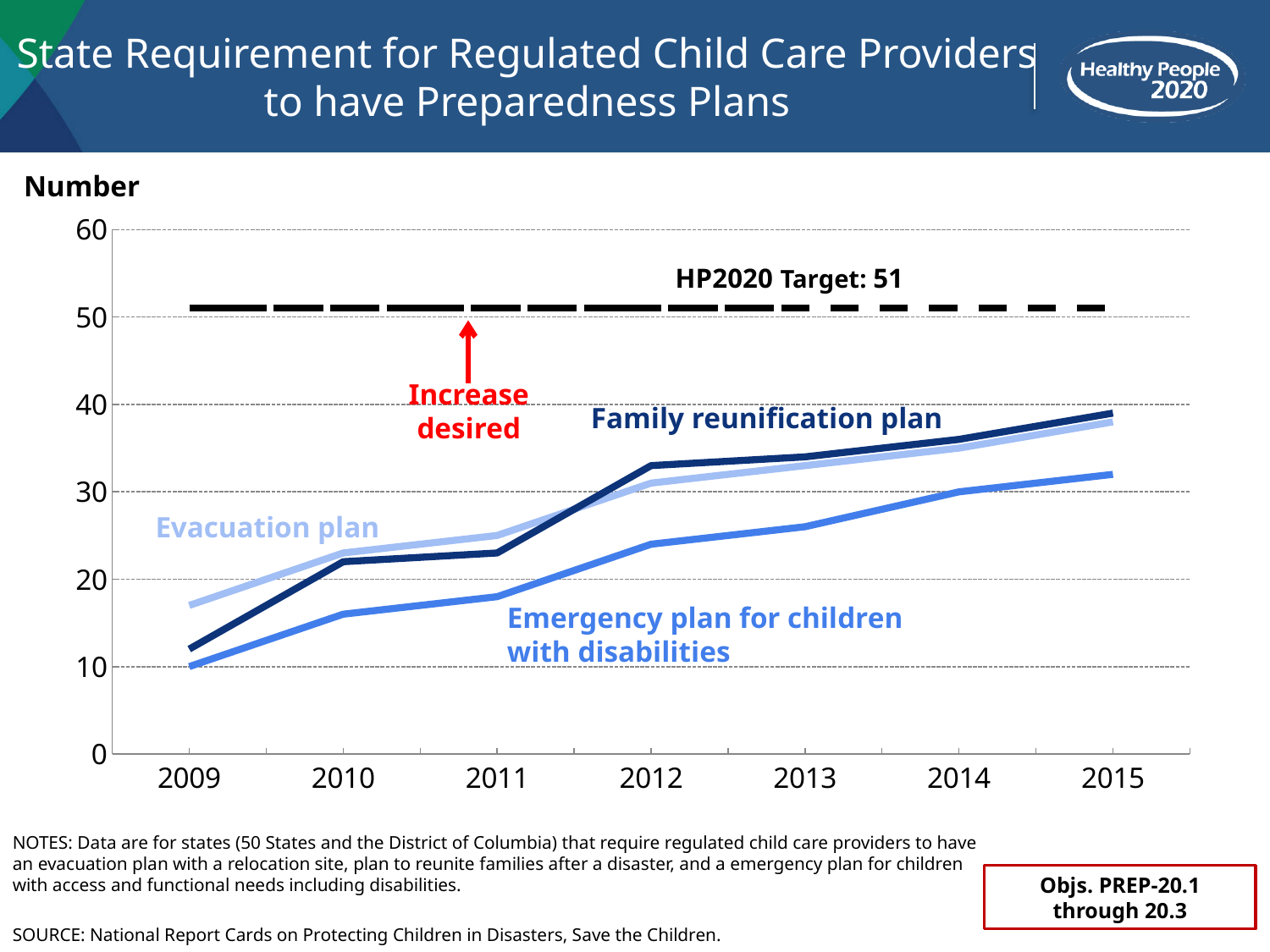
Is the value for the Emergency plan for children with disabilities in 2015 greater or less than 40? less Which series has the lowest value in 2015? Emergency plan for children with disabilities What kind of chart is shown on the slide? line chart Is the value for the Evacuation plan in 2009 greater or less than 20? less How many data series (lines) are plotted in the chart, excluding the target line? 3 Is the value for the Family reunification plan in 2015 greater or less than 30? greater What does the red text on the chart say is desired? Increase desired What is the HP2020 Target value shown on the chart? 51 How many years are shown on the x axis of the chart? 7 In 2015, which is higher: the Family reunification plan or the Emergency plan for children with disabilities? Family reunification plan Do the values for the Family reunification plan rise or fall from 2009 to 2015? rise